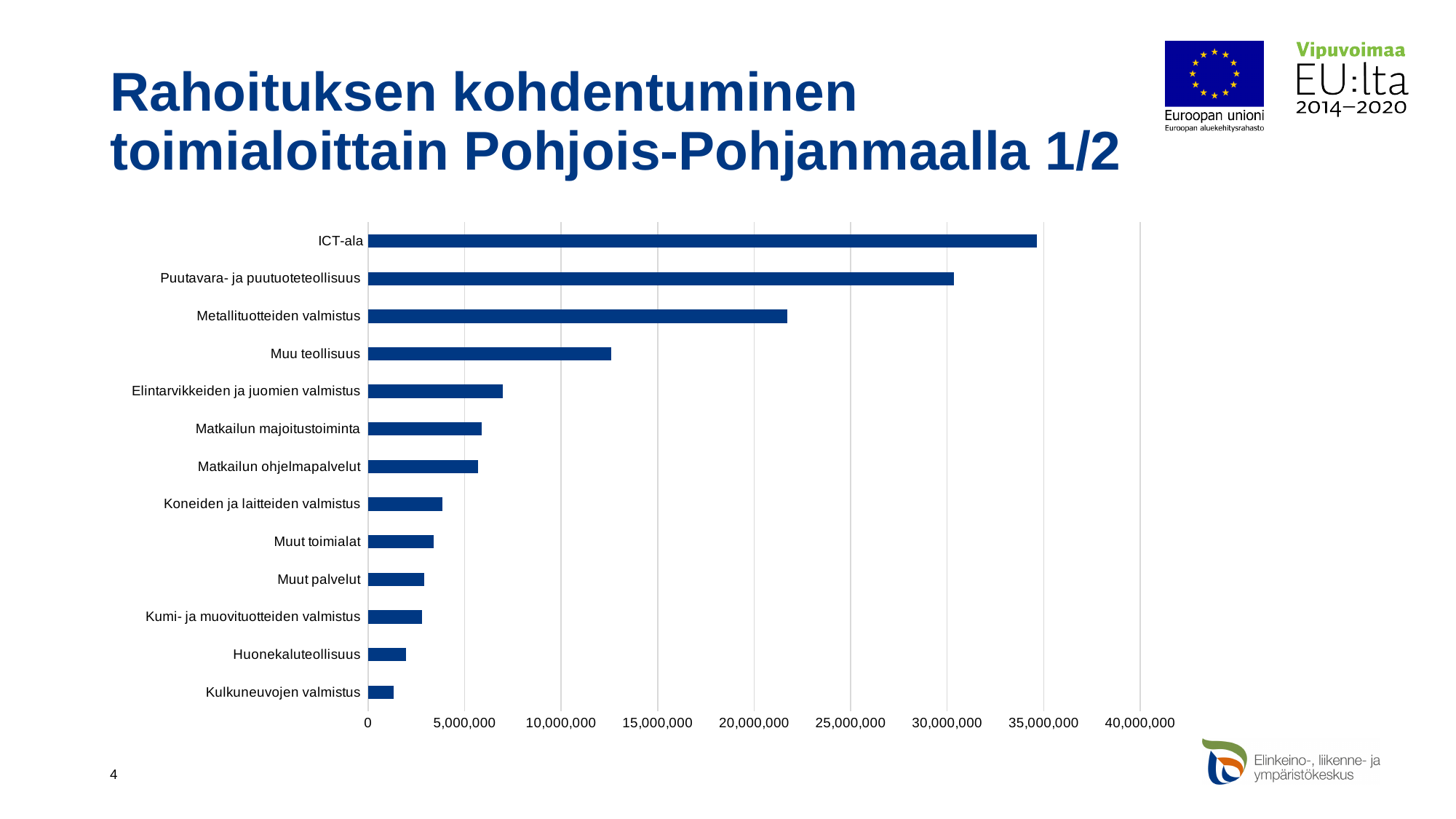
Which has a larger value, Koneiden ja laitteiden valmistus or Kulkuneuvojen valmistus? Koneiden ja laitteiden valmistus Is the value for Muu teollisuus greater or less than 10,000,000? greater Is the value for Elintarvikkeiden ja juomien valmistus greater or less than 10,000,000? less Is the value for Huonekaluteollisuus greater or less than 5,000,000? less What is the title of the slide containing the chart? Rahoituksen kohdentuminen toimialoittain Pohjois-Pohjanmaalla 1/2 Which category has the highest value in the chart? ICT-ala Which category has the lowest value in the chart? Kulkuneuvojen valmistus Which has a larger value, Puutavara- ja puutuoteteollisuus or Metallituotteiden valmistus? Puutavara- ja puutuoteteollisuus How many categories (toimialat) are plotted in the chart? 13 What kind of chart is shown on the slide? bar chart